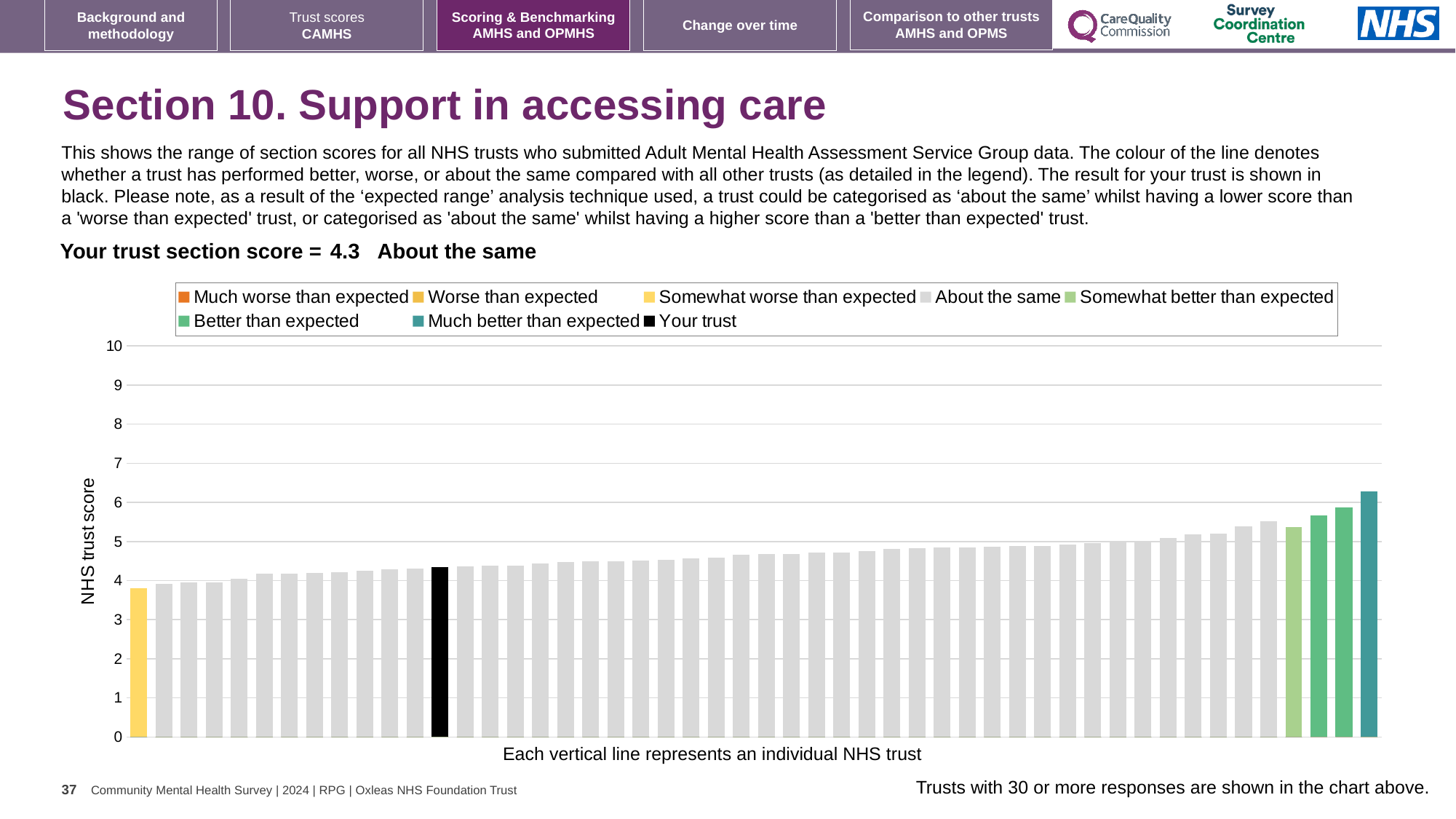
Which legend category does the highest-scoring trust belong to? Much better than expected Do the bar values rise or fall from left to right along the x axis? rise Which category is your trust placed in for this section? About the same What type of chart is shown on the slide? bar chart Which legend category does the lowest-scoring trust belong to? Somewhat worse than expected What is the section score for your trust? 4.3 How many bars are coloured as 'Worse than expected'? 0 Is the value for your trust greater or less than 5? less Is the value of the shortest bar greater or less than 4? less What is the label on the vertical axis of the chart? NHS trust score How many entries does the chart legend list? 8 Is the value of the tallest bar greater or less than 6? greater